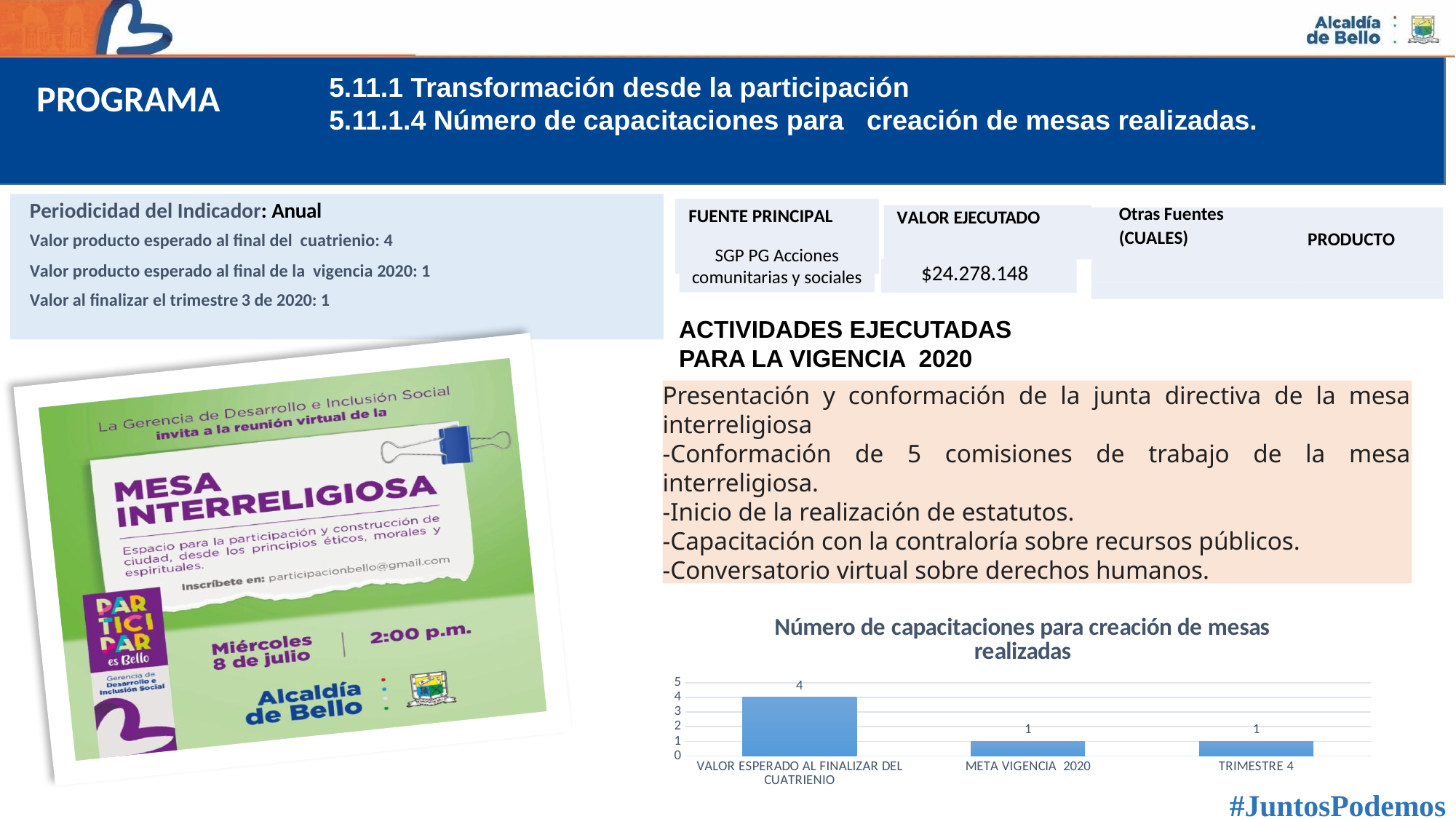
Which is larger, the value for VALOR ESPERADO AL FINALIZAR DEL CUATRIENIO or the value for TRIMESTRE 4? VALOR ESPERADO AL FINALIZAR DEL CUATRIENIO Is the value for VALOR ESPERADO AL FINALIZAR DEL CUATRIENIO greater or less than 3? greater How many categories are shown in the chart? 3 What is the value for TRIMESTRE 4 in the chart? 1 What kind of chart is shown on the slide? bar chart What is the difference between the value for VALOR ESPERADO AL FINALIZAR DEL CUATRIENIO and the value for META VIGENCIA 2020? 3 What is the highest value shown on the chart's vertical axis? 5 What is the value for VALOR ESPERADO AL FINALIZAR DEL CUATRIENIO in the chart? 4 What is the value for META VIGENCIA 2020 in the chart? 1 What is the title of the chart? Número de capacitaciones para creación de mesas realizadas Is the value for META VIGENCIA 2020 greater or less than 2? less Which category has the highest value in the chart? VALOR ESPERADO AL FINALIZAR DEL CUATRIENIO